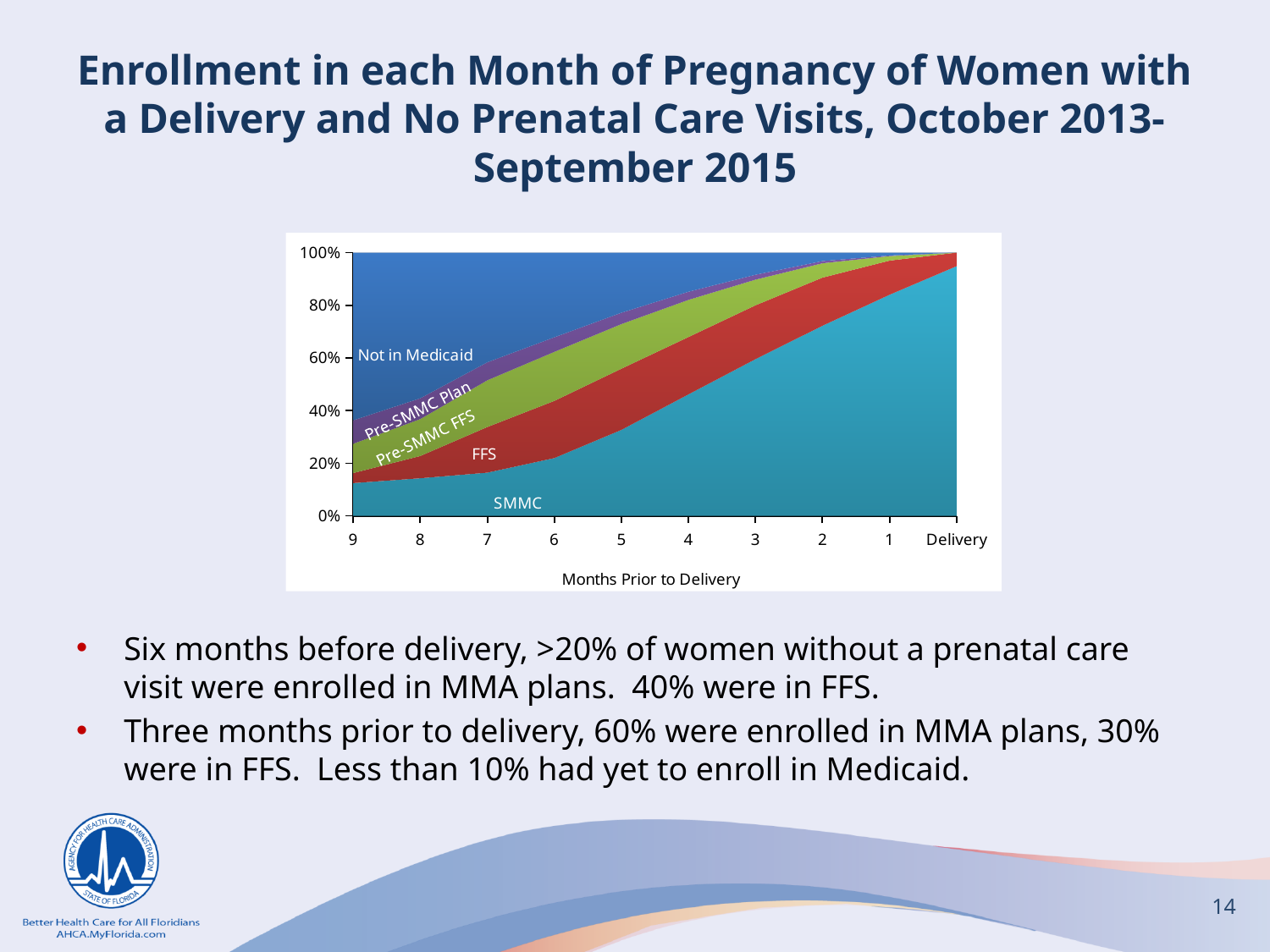
How many points are shown along the x axis of the chart? 10 Which category is plotted at the bottom of the stacked area chart? SMMC Is the SMMC share at 2 months prior to delivery greater or less than 60%? greater Which category is larger at Delivery, SMMC or FFS? SMMC How many enrollment categories (series) are labeled in the chart? 5 Does the SMMC share rise or fall as the months move from 9 months prior toward Delivery? Rises What is the title of the x axis of the chart? Months Prior to Delivery Is the Not in Medicaid share at 9 months prior to delivery greater or less than 40%? greater Does the Not in Medicaid share rise or fall as the months move from 9 months prior toward Delivery? Falls Is the SMMC share at 9 months prior to delivery greater or less than 20%? less What kind of chart is shown on the slide? Area chart